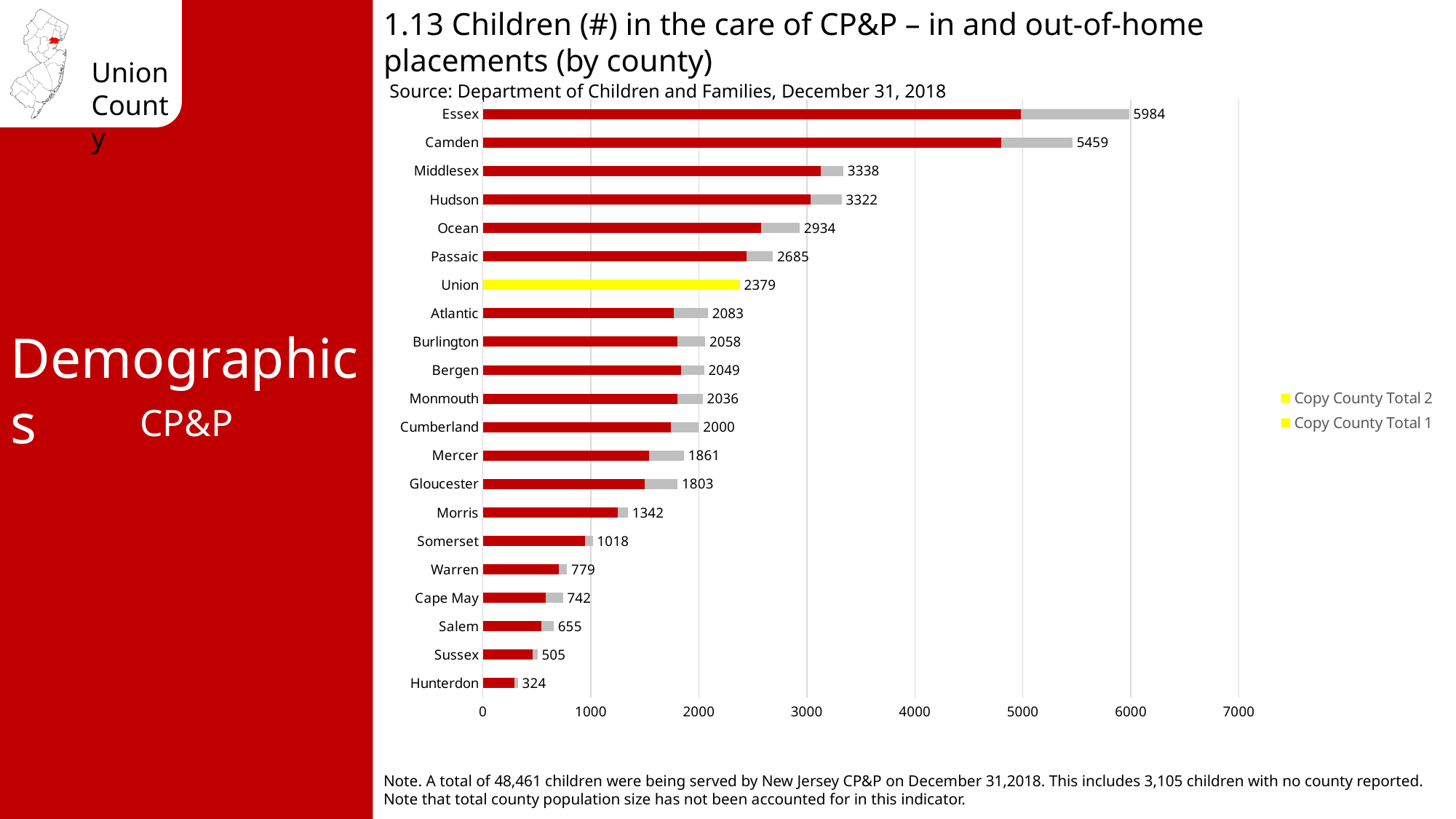
Which county's bar is highlighted in yellow? Union What is the difference between the totals for Essex and Camden? 525 How many series does the legend list? 2 What is the total number of children in the care of CP&P for Hunterdon county? 324 What kind of chart is shown on the slide? Stacked horizontal bar chart Which county has the highest total number of children in the care of CP&P? Essex Which county has a larger total, Ocean or Passaic? Ocean What is the total number of children in the care of CP&P for Union county? 2379 Is the red (in-home) portion of the bar for Essex greater or less than 4000? greater What is the total number of children in the care of CP&P for Essex county? 5984 How many counties are shown in the chart? 21 Which county has the lowest total number of children in the care of CP&P? Hunterdon